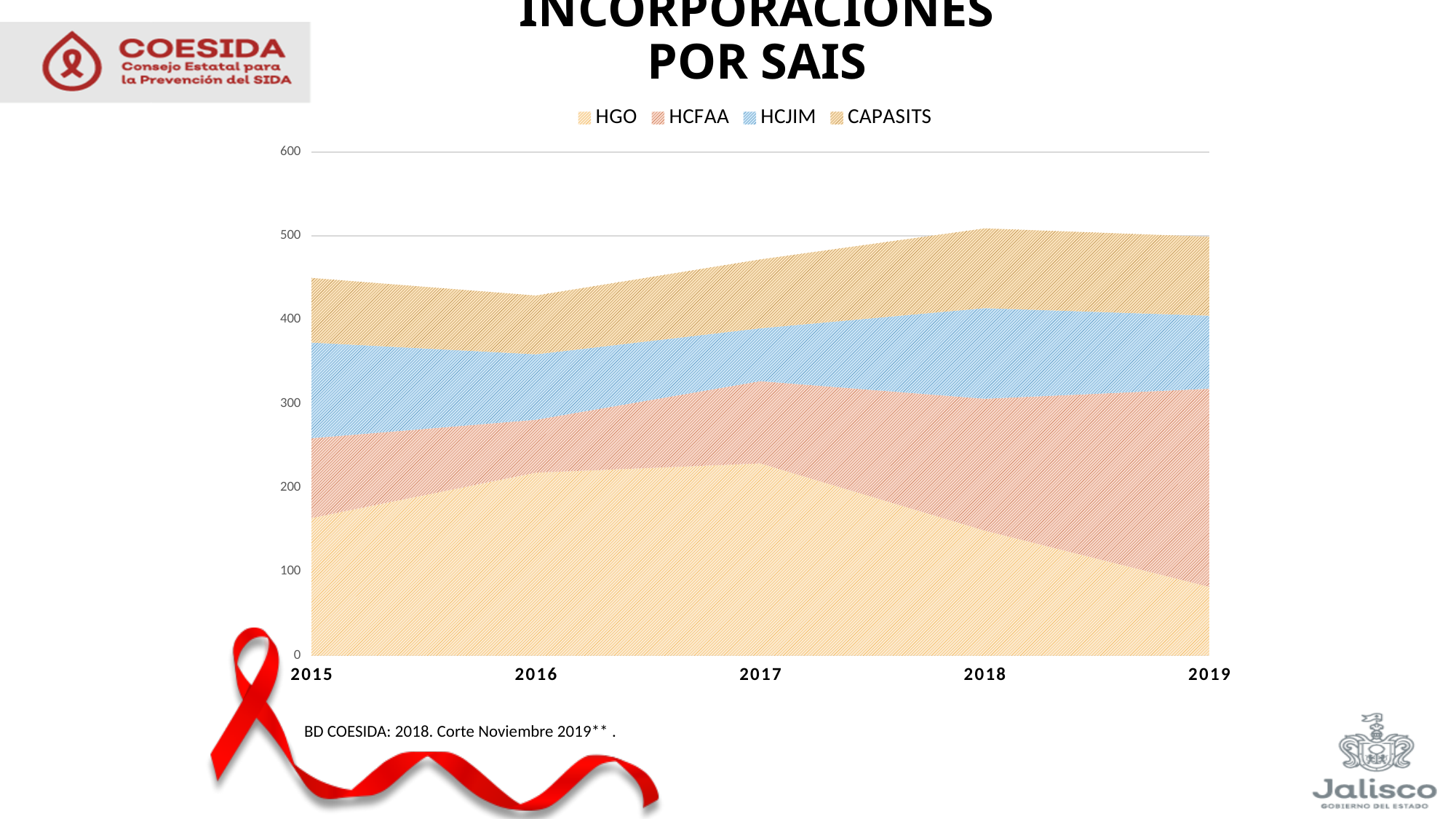
Is the stacked total for 2015 greater or less than 500? less How many years are shown along the x axis? 5 Is the value for HGO in 2015 greater or less than 100? greater Does the value for HGO rise or fall from 2015 to 2017? rise What kind of chart is shown on the slide? Stacked area chart What is the title of the chart? INCORPORACIONES POR SAIS Is the stacked total for 2016 greater or less than 500? less Does the value for HGO rise or fall from 2017 to 2019? fall How many series does the legend list? 4 Which series are listed in the legend? HGO, HCFAA, HCJIM, CAPASITS